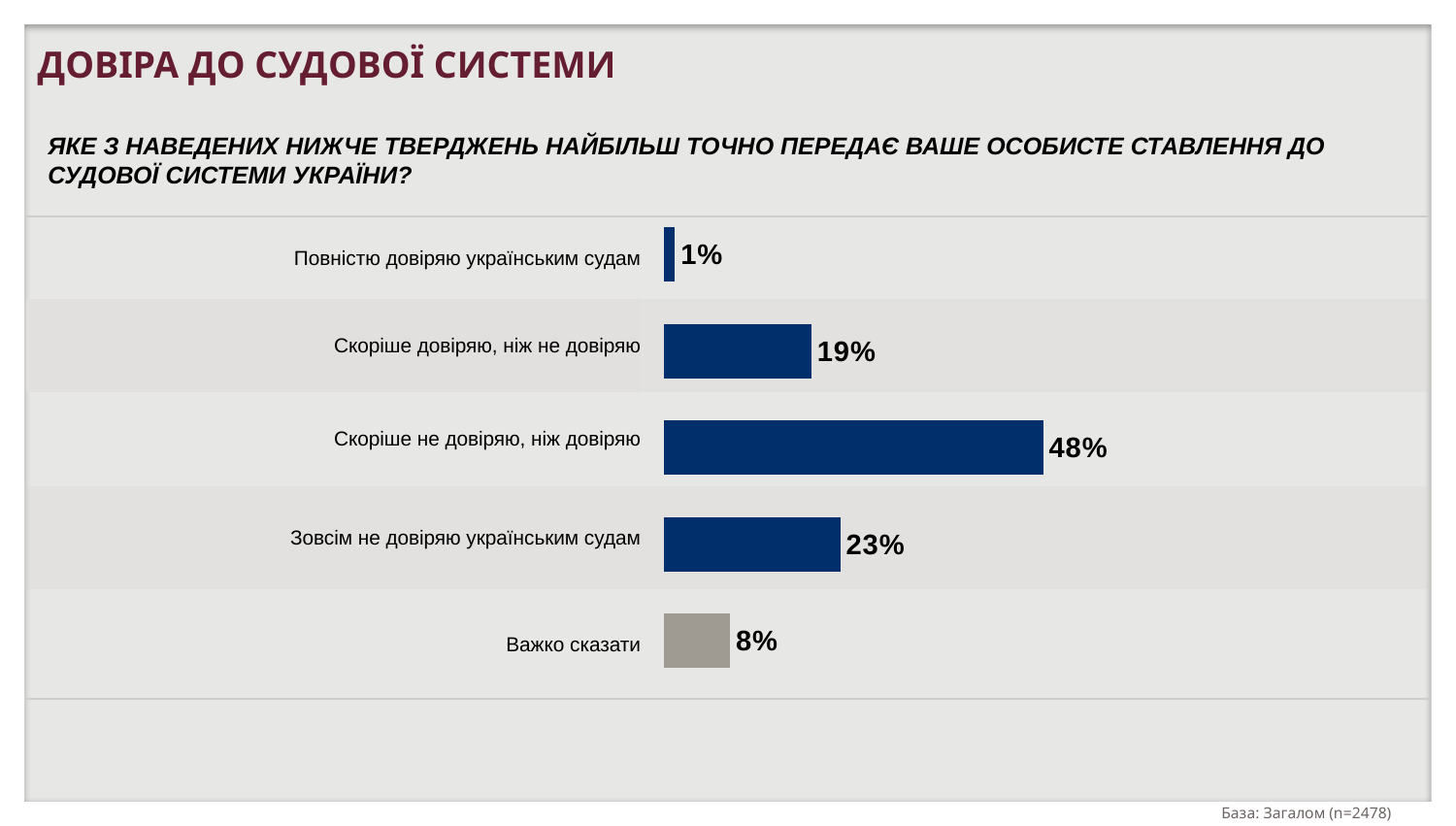
Which bar is shown in a different colour (grey) from the others? Важко сказати Which category has the highest value? Скоріше не довіряю, ніж довіряю Which is larger: "Скоріше довіряю, ніж не довіряю" or "Зовсім не довіряю українським судам"? Зовсім не довіряю українським судам What is the value shown for "Повністю довіряю українським судам"? 1% What type of chart is shown on the slide? Bar chart Which category has the lowest value? Повністю довіряю українським судам What percentage of respondents chose "Скоріше не довіряю, ніж довіряю"? 48% What percentage is shown for "Важко сказати"? 8% What is the combined value of "Повністю довіряю українським судам" and "Скоріше довіряю, ніж не довіряю"? 20% What is the difference between "Скоріше не довіряю, ніж довіряю" and "Зовсім не довіряю українським судам"? 25% How many categories are shown in the chart? 5 What is the value for "Зовсім не довіряю українським судам"? 23%